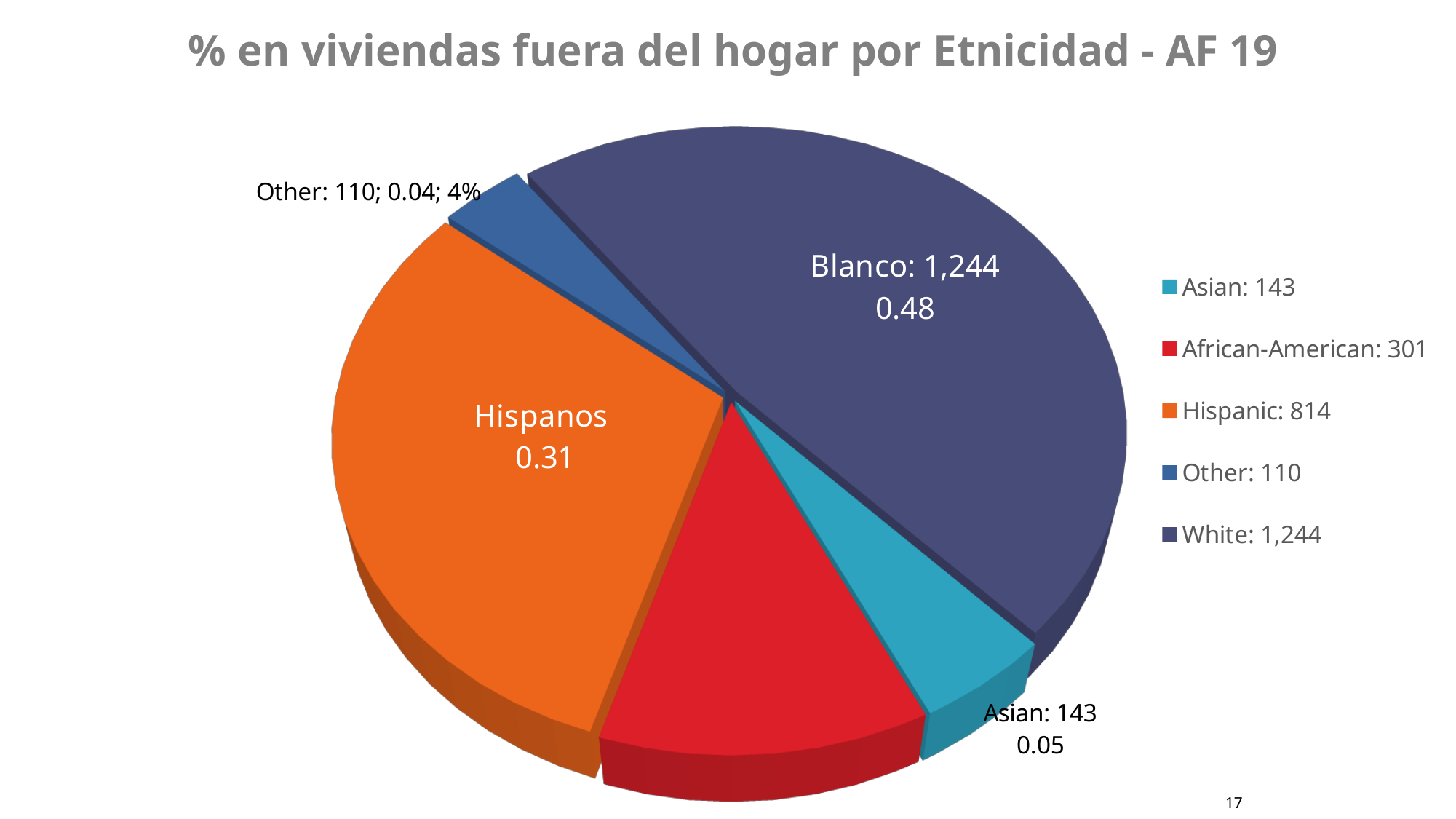
What share of the pie is shown on the data label for the Hispanos slice? 0.31 What share of the pie is shown on the data label for the Blanco slice? 0.48 What is the difference between the White value and the Hispanic value? 430 What is the value for Asian in the pie chart? 143 Which category has the largest slice of the pie? White What type of chart is shown on the slide? Pie chart What is the value for White in the pie chart? 1,244 Which is larger, the value for African-American or the value for Asian? African-American What is the value for Hispanic according to the legend? 814 What is the value for African-American according to the legend? 301 How many categories does the legend list? 5 Which category has the smallest slice of the pie? Other